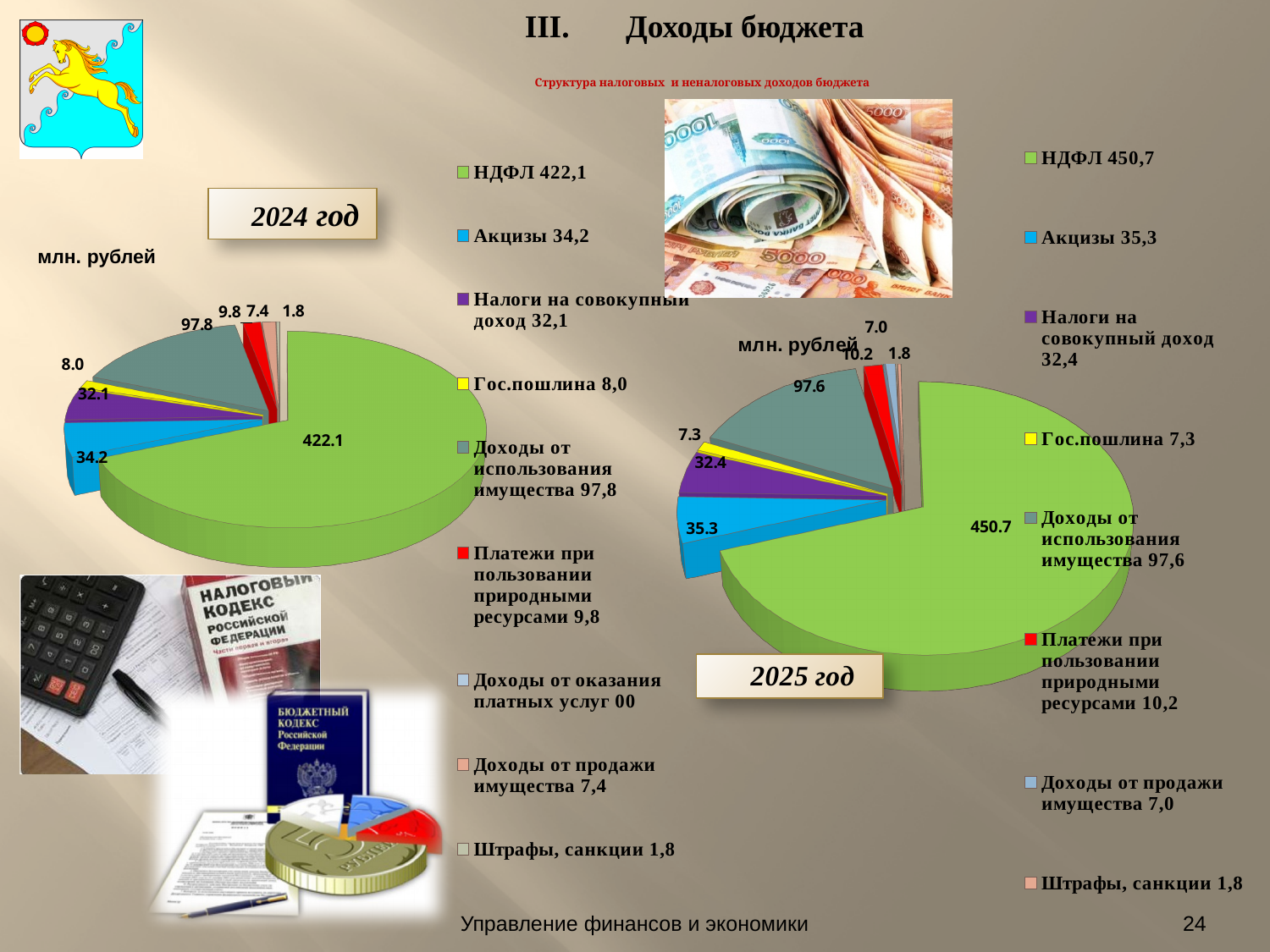
In the 2025 год chart, what is the value for Платежи при пользовании природными ресурсами? 10.2 What is the difference between the НДФЛ value in the 2025 год chart and the НДФЛ value in the 2024 год chart? 28.6 In the 2024 год chart, what is the value for Доходы от использования имущества? 97.8 In the 2025 год chart, which is larger: Гос.пошлина or Доходы от продажи имущества? Гос.пошлина In the 2024 год chart, what is the value for НДФЛ? 422.1 What type of chart is used for the 2024 год chart? pie chart In the 2024 год chart, which category has the smallest non-zero value? Штрафы, санкции In the 2025 год chart, what is the value for Акцизы? 35.3 How many entries does the legend of the 2025 год chart list? 8 In the 2024 год chart, what is the difference between Акцизы and Налоги на совокупный доход? 2.1 In the 2025 год chart, which category has the largest value? НДФЛ How many categories does the legend of the 2024 год chart list? 9